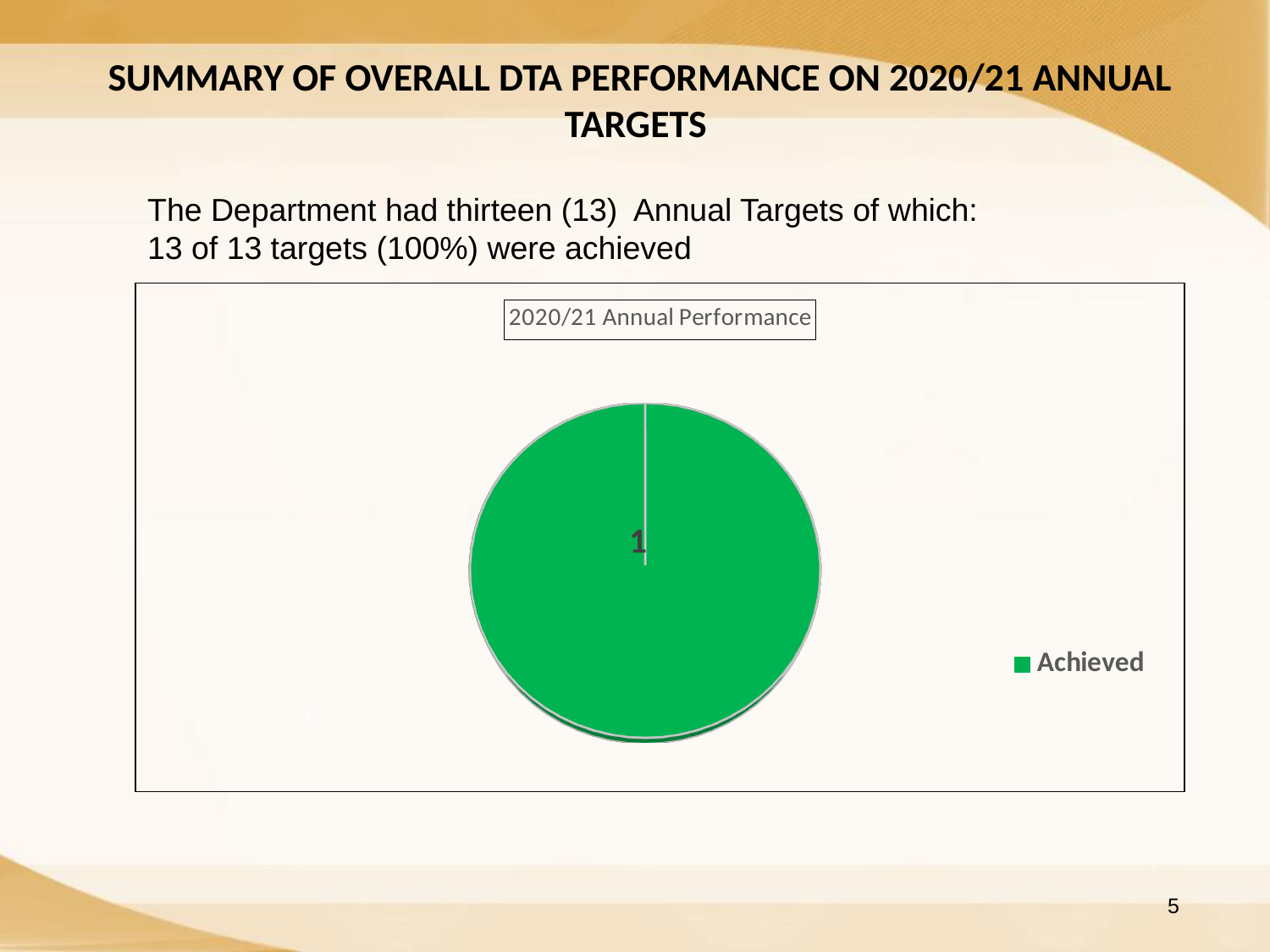
What is the title of the chart? 2020/21 Annual Performance What is the legend entry shown for the chart? Achieved How many series does the chart legend list? 1 What share of the pie does the Achieved slice take up? 100% How many slices does the pie chart have? 1 What kind of chart is shown on the slide? pie chart What value is printed on the Achieved slice of the pie chart? 1